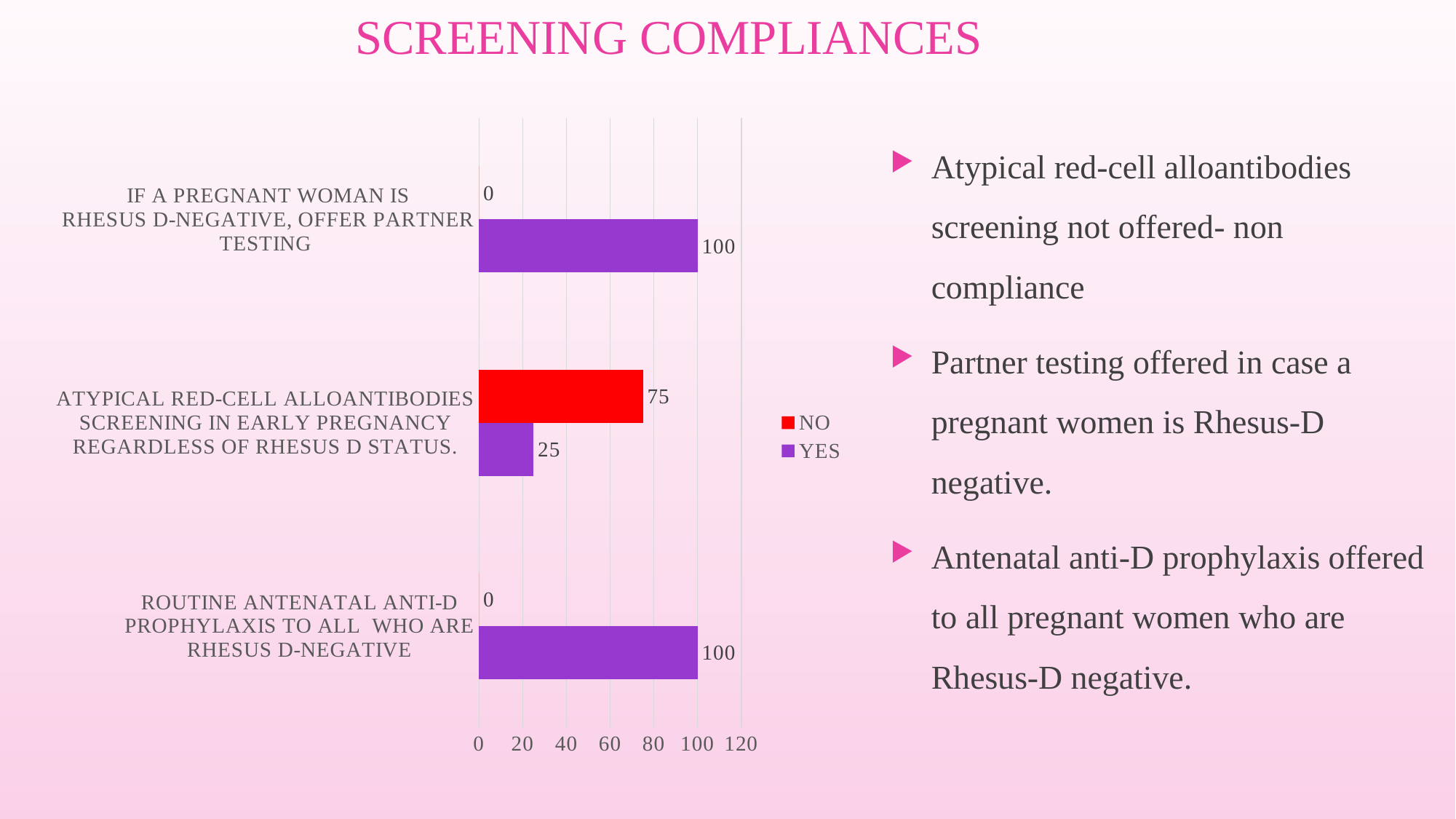
What is the NO value for 'If a pregnant woman is Rhesus D-negative, offer partner testing'? 0 Which category has the highest NO value? Atypical red-cell alloantibodies screening in early pregnancy regardless of Rhesus D status What is the NO value for 'Atypical red-cell alloantibodies screening in early pregnancy regardless of Rhesus D status'? 75 How many categories are shown on the chart? 3 For 'Atypical red-cell alloantibodies screening in early pregnancy regardless of Rhesus D status', which is larger, the NO value or the YES value? NO What is the YES value for 'Routine antenatal anti-D prophylaxis to all who are Rhesus D-negative'? 100 What kind of chart is shown on the slide? Bar chart What is the YES value for 'Atypical red-cell alloantibodies screening in early pregnancy regardless of Rhesus D status'? 25 How many series does the legend list? 2 Which category has the lowest YES value? Atypical red-cell alloantibodies screening in early pregnancy regardless of Rhesus D status What colour represents the NO series in the chart? Red What is the difference between the NO and YES values for 'Atypical red-cell alloantibodies screening in early pregnancy regardless of Rhesus D status'? 50